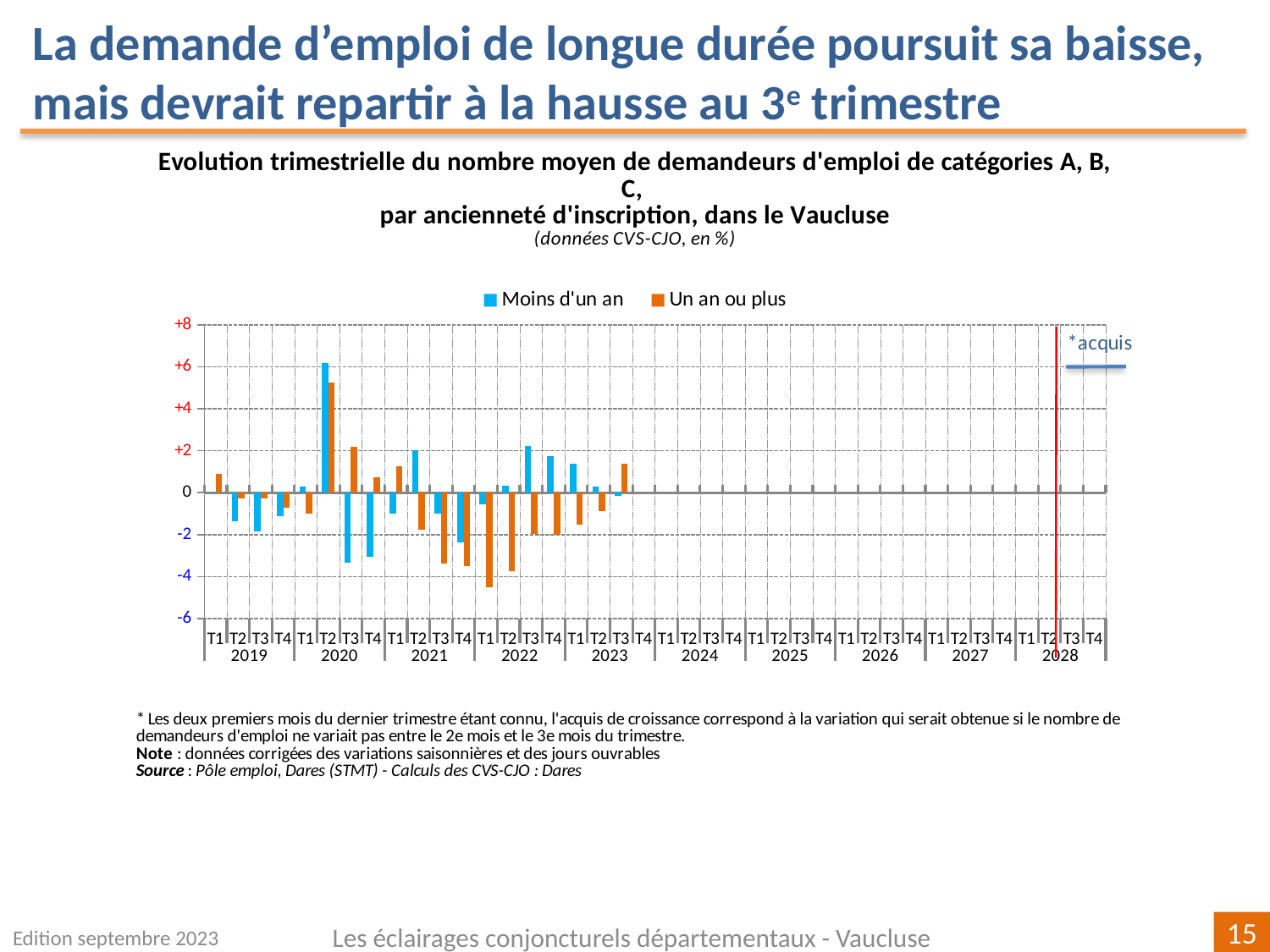
Is the value for 'Moins d'un an' in T2 2020 greater or less than +4? greater How many years are labelled along the x axis? 10 How many series does the legend list? 2 What kind of chart is shown on the slide? bar chart In T3 2020, which series has the larger value, 'Moins d'un an' or 'Un an ou plus'? Un an ou plus Does the 'Un an ou plus' series generally rise or fall from T1 2022 to T3 2023? rise Is the value for 'Un an ou plus' in T3 2021 greater or less than -2? less What are the two series named in the legend? Moins d'un an; Un an ou plus Is the value for 'Un an ou plus' in T1 2022 greater or less than -4? less In T1 2022, which series has the larger value, 'Moins d'un an' or 'Un an ou plus'? Moins d'un an In which quarter does the 'Moins d'un an' series reach its highest value? T2 2020 In which quarter does the 'Un an ou plus' series reach its lowest value? T1 2022